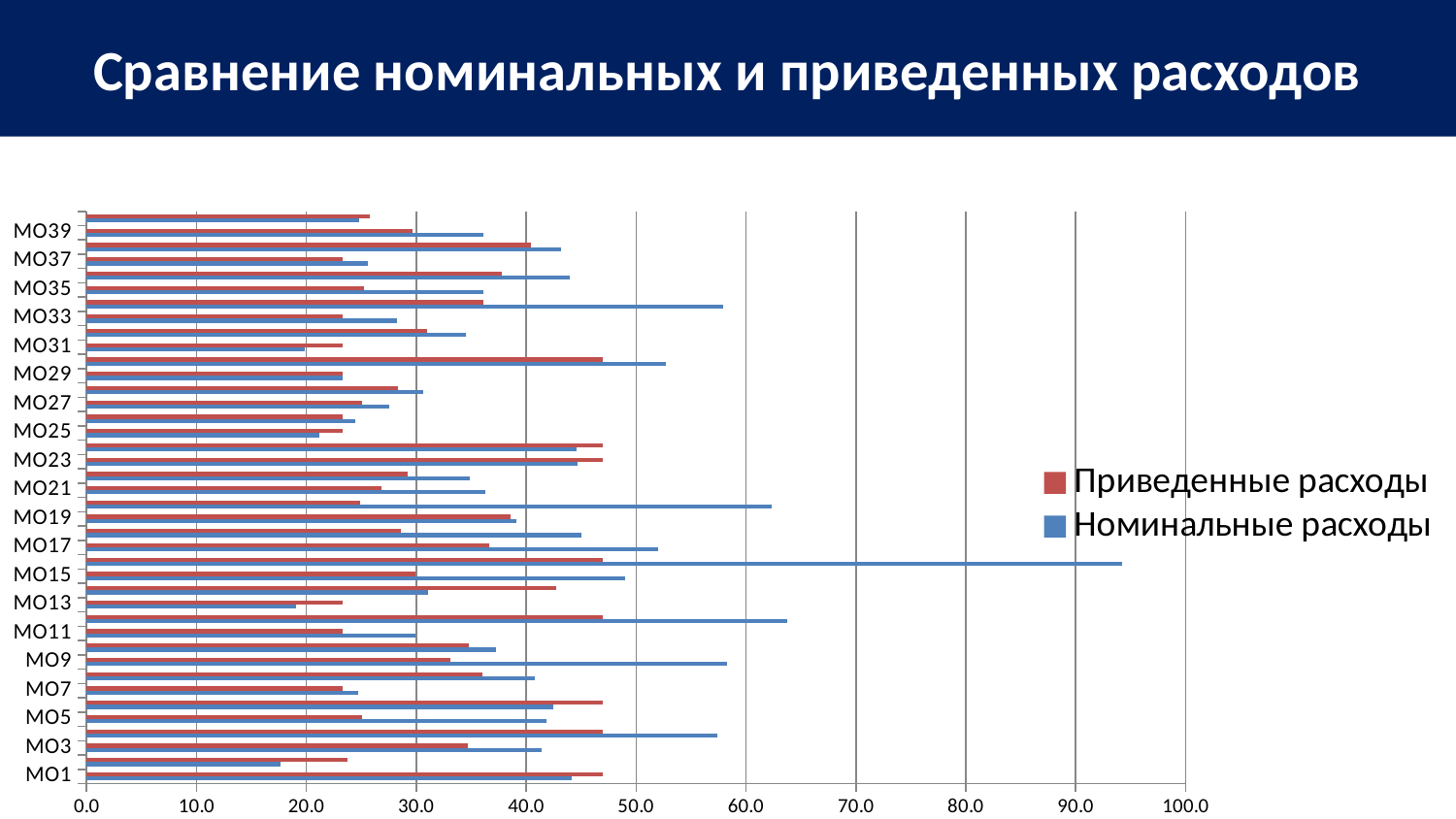
Is the longest Номинальные расходы bar greater or less than 90? greater Is the value of Номинальные расходы for MO1 greater or less than 40? greater Which series is shown in red in the legend? Приведенные расходы Which series contains the single longest bar on the chart, Приведенные расходы or Номинальные расходы? Номинальные расходы What kind of chart is shown on the slide? Bar chart How many series does the legend list? 2 Is the value of Приведенные расходы for MO1 greater or less than 40? greater What is the title of the chart? Сравнение номинальных и приведенных расходов